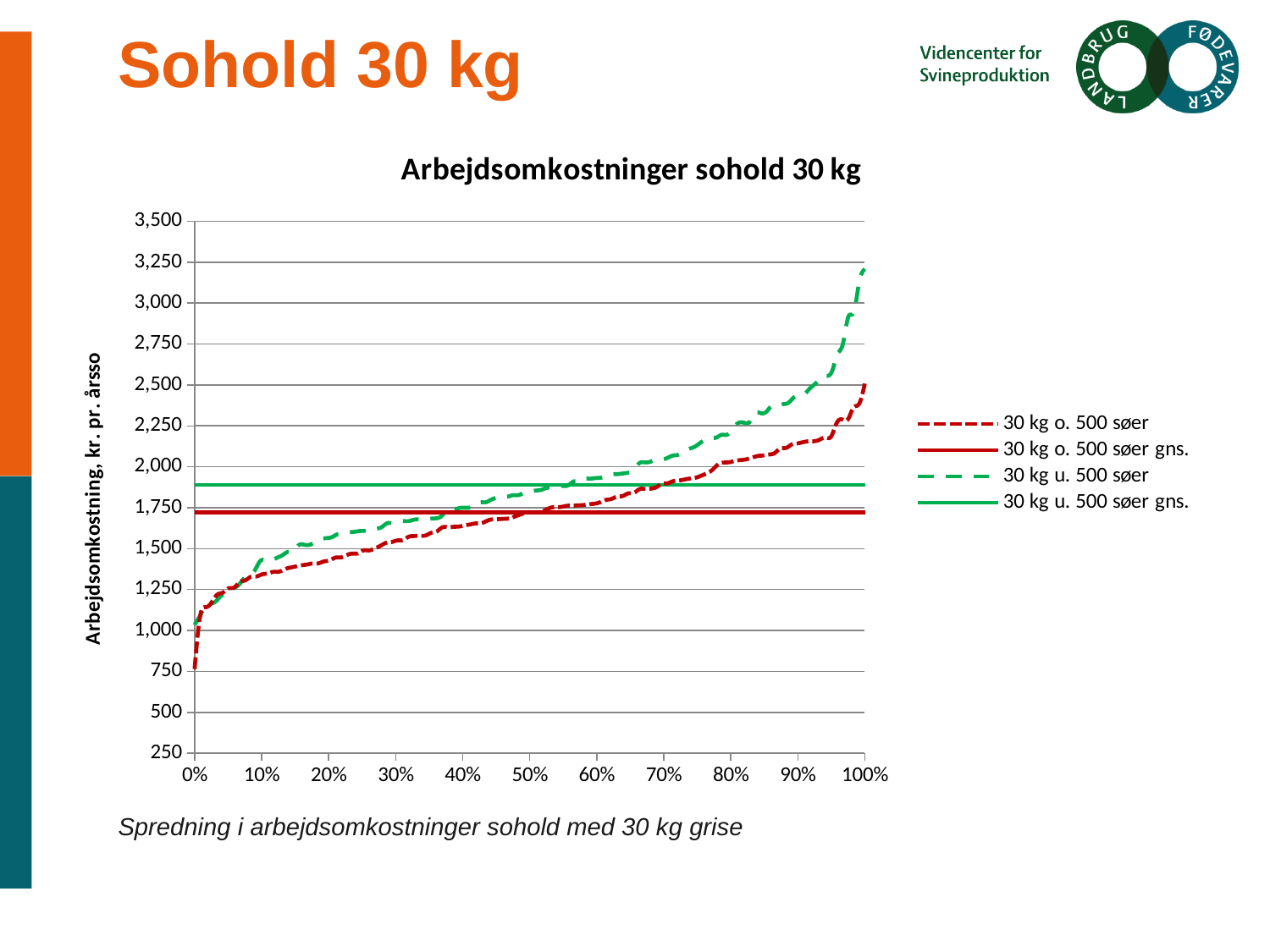
How many series does the legend list? 4 At 100%, which series has the higher value: '30 kg u. 500 søer' or '30 kg o. 500 søer'? 30 kg u. 500 søer What is the highest value shown on the vertical axis? 3,500 What kind of chart is shown on the slide? line chart Is the value of the '30 kg o. 500 søer' series at 0% greater or less than 1,000? less What is the title of the chart? Arbejdsomkostninger sohold 30 kg Which average line is higher: '30 kg o. 500 søer gns.' or '30 kg u. 500 søer gns.'? 30 kg u. 500 søer gns. Is the value of the '30 kg u. 500 søer' series at 100% greater or less than 3,000? greater What is the label on the vertical axis of the chart? Arbejdsomkostning, kr. pr. årsso Do the values of the '30 kg u. 500 søer' series rise or fall from 0% to 100% along the x axis? rise Is the value of the '30 kg o. 500 søer gns.' line greater or less than 1,500? greater